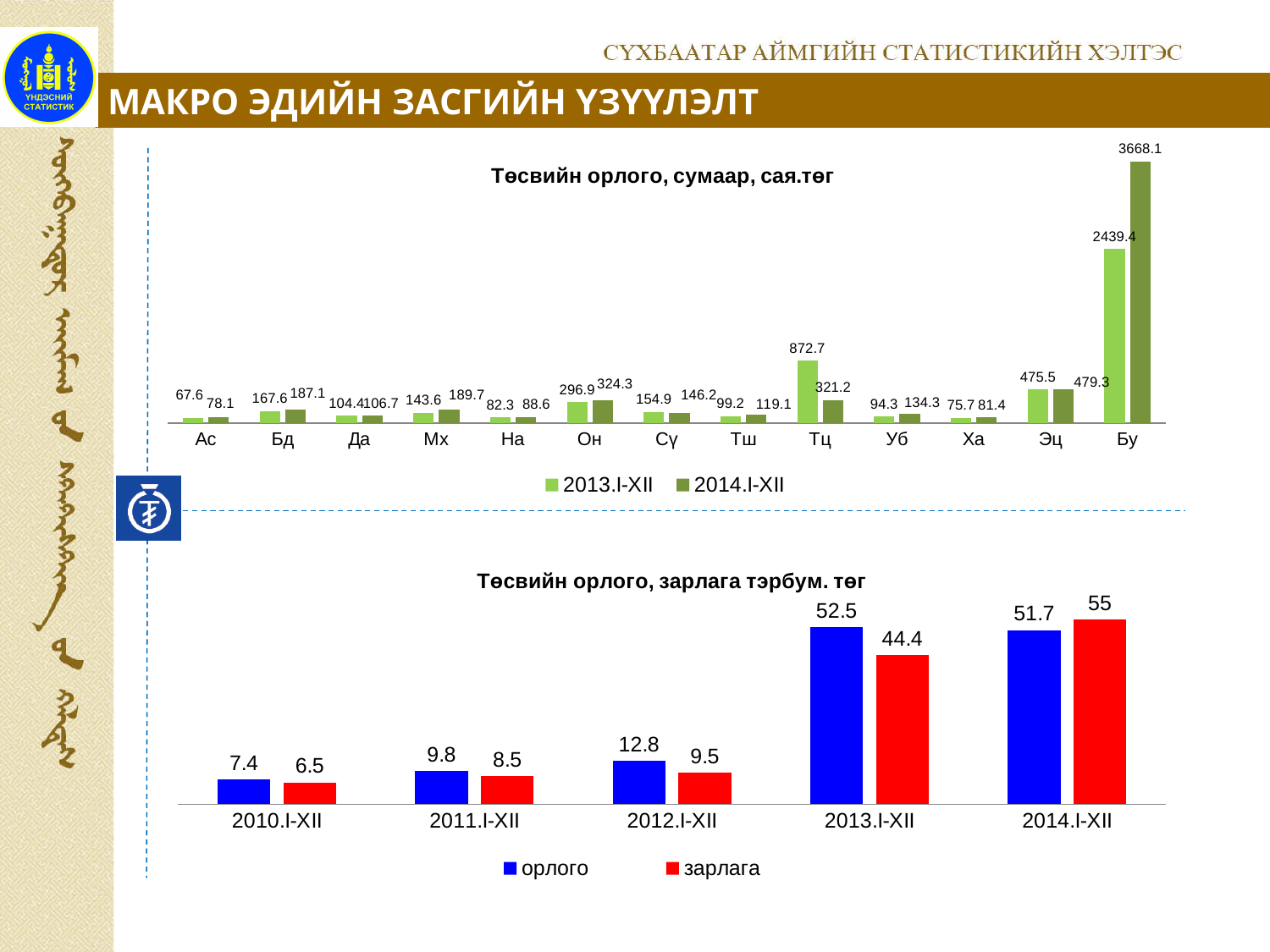
What kind of chart is the one titled 'Төсвийн орлого, зарлага тэрбум. төг'? Bar chart In the chart titled 'Төсвийн орлого, сумаар, сая.төг', what is the 2013.I-XII value for Тц? 872.7 In the chart titled 'Төсвийн орлого, зарлага тэрбум. төг', how many periods are shown on the x axis? 5 In the chart titled 'Төсвийн орлого, сумаар, сая.төг', which category has the lowest 2014.I-XII value? Ас In the chart titled 'Төсвийн орлого, сумаар, сая.төг', what is the 2014.I-XII value for Бу? 3668.1 In the chart titled 'Төсвийн орлого, зарлага тэрбум. төг', what is the difference between орлого and зарлага for 2012.I-XII? 3.3 In the chart titled 'Төсвийн орлого, сумаар, сая.төг', what is the difference between the 2014.I-XII and 2013.I-XII values for Бу? 1228.7 In the chart titled 'Төсвийн орлого, сумаар, сая.төг', how many series does the legend list? 2 In the chart titled 'Төсвийн орлого, сумаар, сая.төг', which category has the highest 2013.I-XII value? Бу In the chart titled 'Төсвийн орлого, сумаар, сая.төг', how many categories are shown on the x axis? 13 In the chart titled 'Төсвийн орлого, зарлага тэрбум. төг', what is the орлого value for 2013.I-XII? 52.5 In the chart titled 'Төсвийн орлого, зарлага тэрбум. төг', which is larger for 2014.I-XII, орлого or зарлага? зарлага